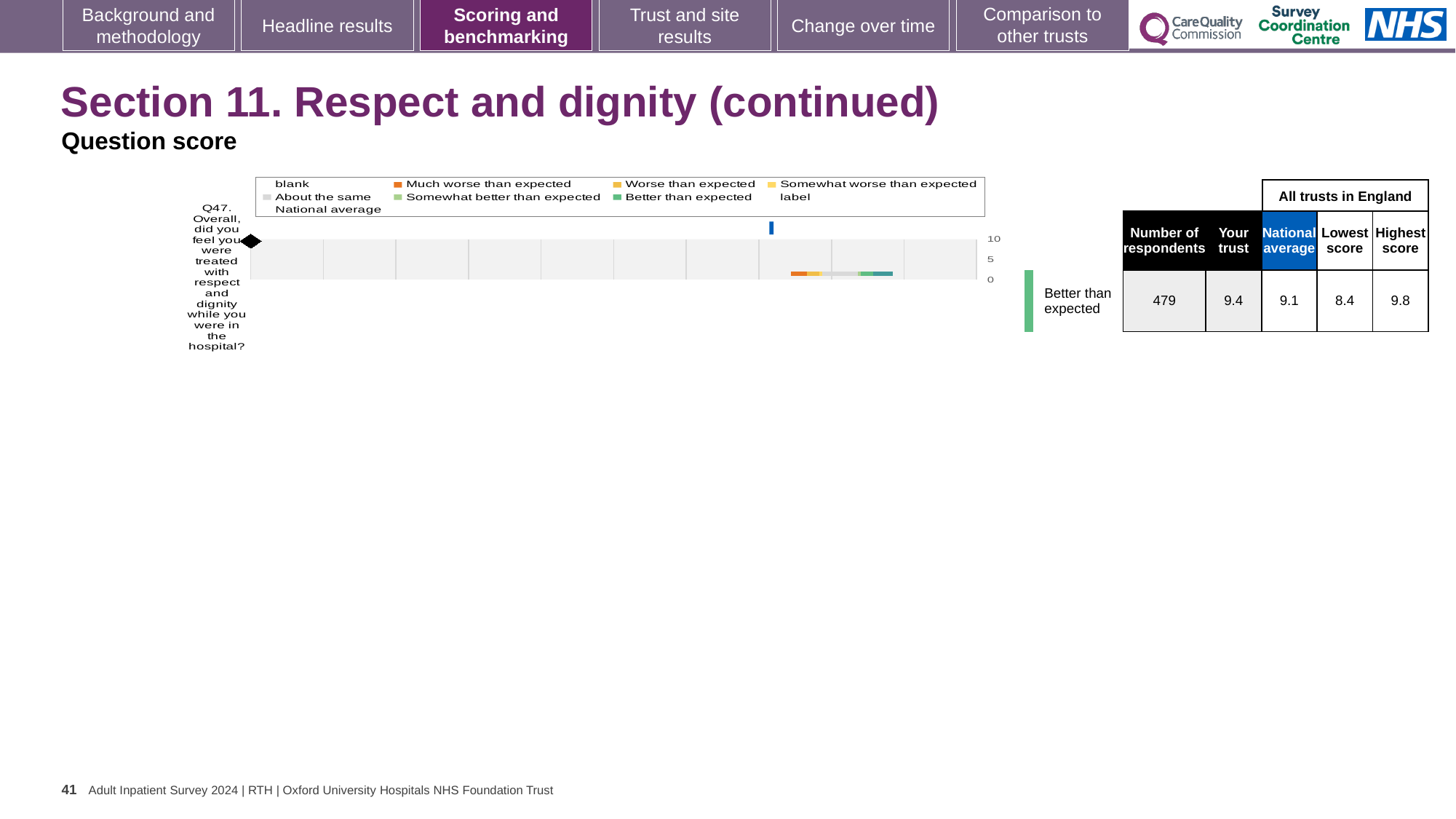
What is the difference between the highest and lowest scores among all trusts in England for Q47? 1.4 What is the difference between the 'Your trust' score and the national average for Q47? 0.3 What is the maximum value shown on the chart's score axis? 10 What is the lowest score among all trusts in England for Q47? 8.4 Is the 'Your trust' score for Q47 greater or less than 5? greater What is the highest score among all trusts in England for Q47? 9.8 What is the 'Your trust' score for Q47 (treated with respect and dignity while in the hospital)? 9.4 What is the national average score for Q47 shown on the slide? 9.1 Which is larger for Q47: the 'Your trust' score or the national average? Your trust What benchmark category is Q47 assigned to on this slide? Better than expected How many respondents answered Q47? 479 How many questions (categories) are plotted on the chart? 1